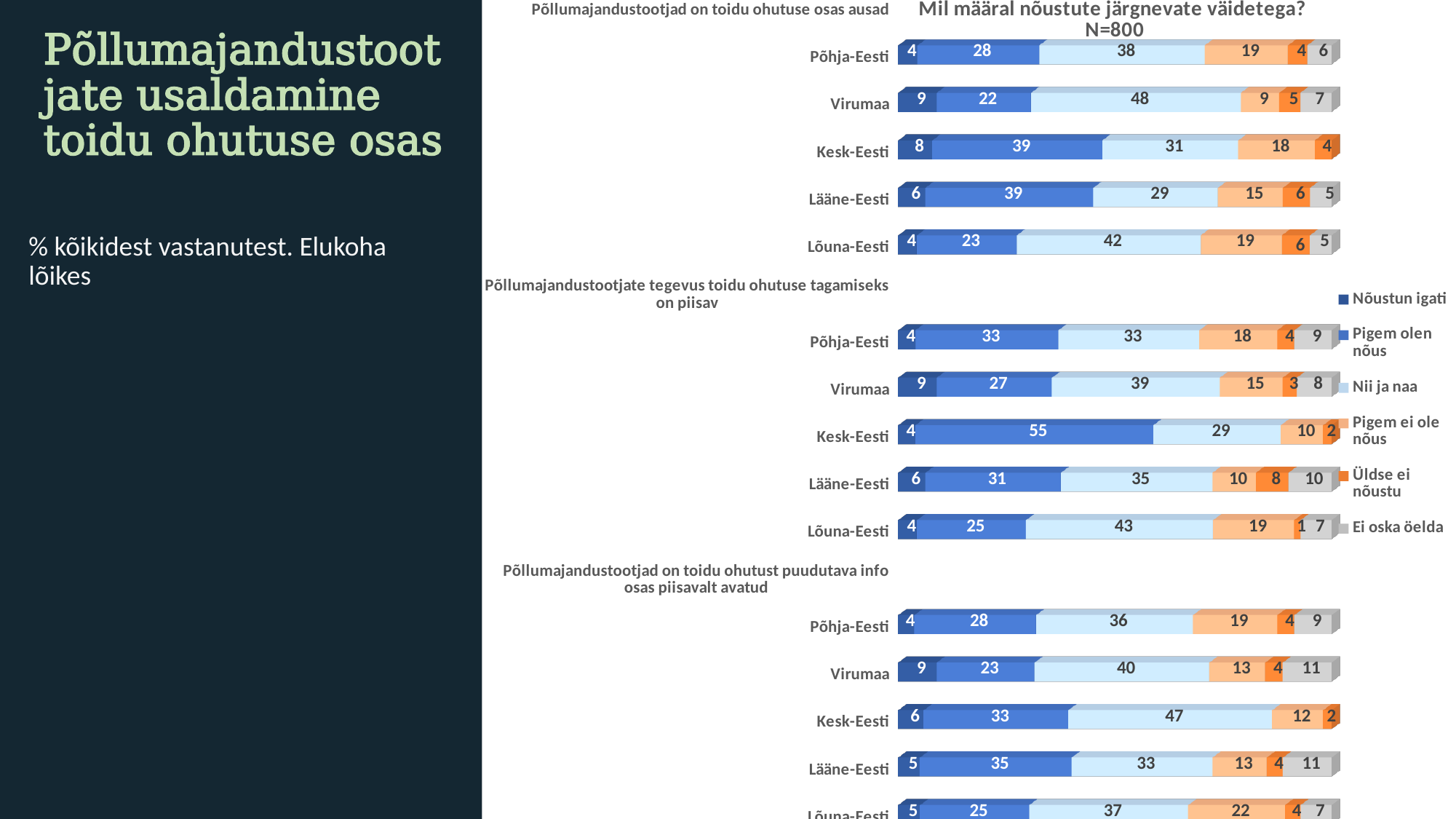
How many series does the legend list? 6 In the statement 'Põllumajandustootjad on toidu ohutuse osas ausad', what is the total of the Põhja-Eesti bar? 99 What sample size (N) is stated in the chart title? N=800 How many regions are shown for each statement? 5 In the statement 'Põllumajandustootjad on toidu ohutuse osas ausad', which is larger: the 'Pigem olen nõus' value for Virumaa or for Lõuna-Eesti? Lõuna-Eesti In the statement 'Põllumajandustootjad on toidu ohutuse osas ausad', which region has the lowest 'Nii ja naa' value? Lääne-Eesti In the statement 'Põllumajandustootjad on toidu ohutust puudutava info osas piisavalt avatud', what is the difference between the 'Nii ja naa' values for Kesk-Eesti and Lääne-Eesti? 14 In the statement 'Põllumajandustootjate tegevus toidu ohutuse tagamiseks on piisav', what is the 'Pigem olen nõus' value for Kesk-Eesti? 55 In the statement 'Põllumajandustootjate tegevus toidu ohutuse tagamiseks on piisav', which region has the highest 'Pigem olen nõus' value? Kesk-Eesti What kind of chart is shown on the slide? Stacked bar chart In the statement 'Põllumajandustootjad on toidu ohutuse osas ausad', what is the 'Nii ja naa' value for Virumaa? 48 In the statement 'Põllumajandustootjad on toidu ohutust puudutava info osas piisavalt avatud', what is the 'Pigem ei ole nõus' value for Lõuna-Eesti? 22